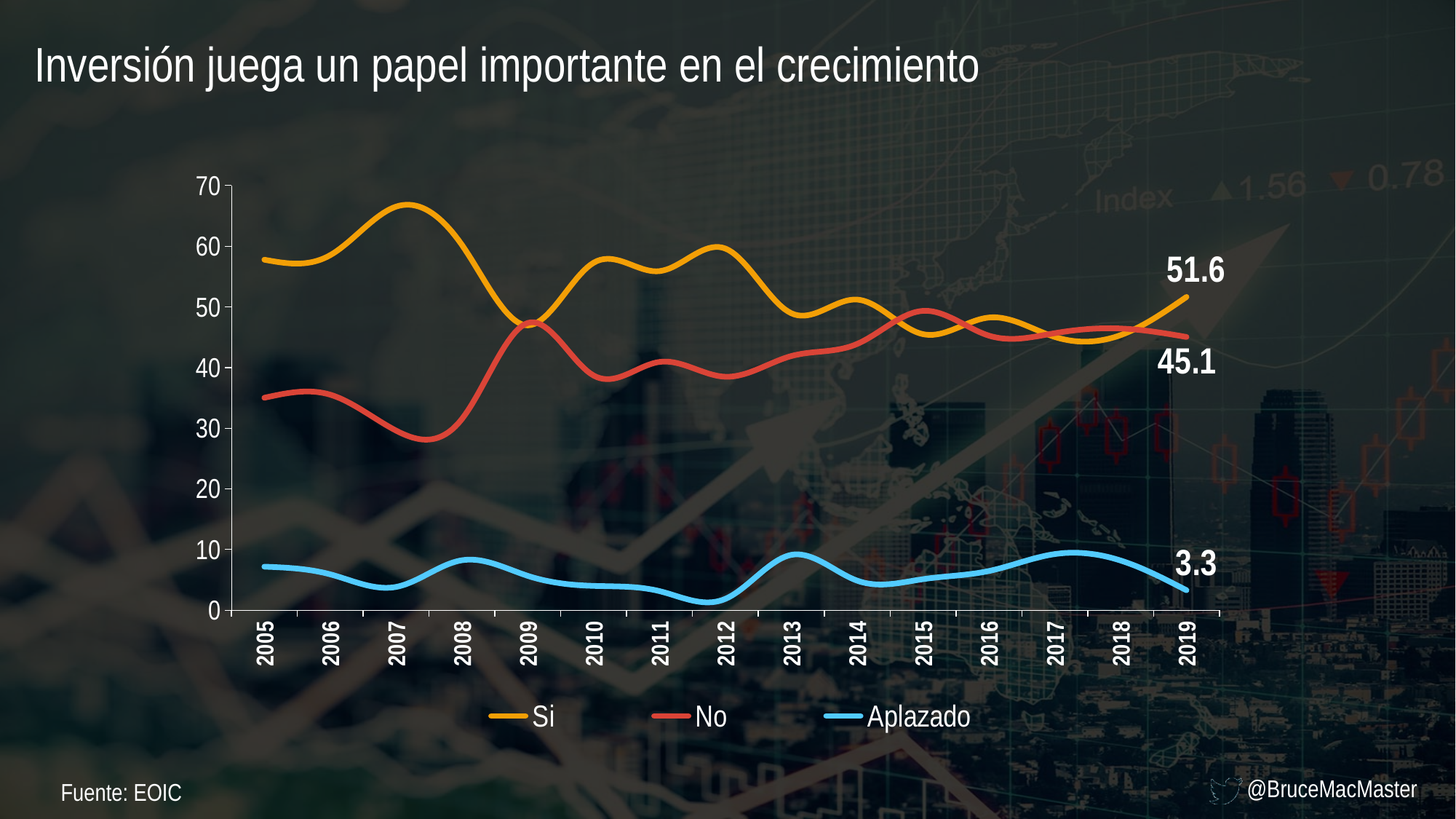
Which series has the highest value in 2019? Si Is the value for No in 2005 greater or less than 40? less What kind of chart is shown on the slide? line chart What is the value of the Si series in 2019? 51.6 What is the value of the No series in 2019? 45.1 How many series does the legend list? 3 What is the value of the Aplazado series in 2019? 3.3 In 2019, which series has the larger value, Si or No? Si What is the difference between the Si and No values in 2019? 6.5 How many years are shown on the x axis? 15 Which series has the lowest value in 2019? Aplazado Is the value for Si in 2007 greater or less than 60? greater